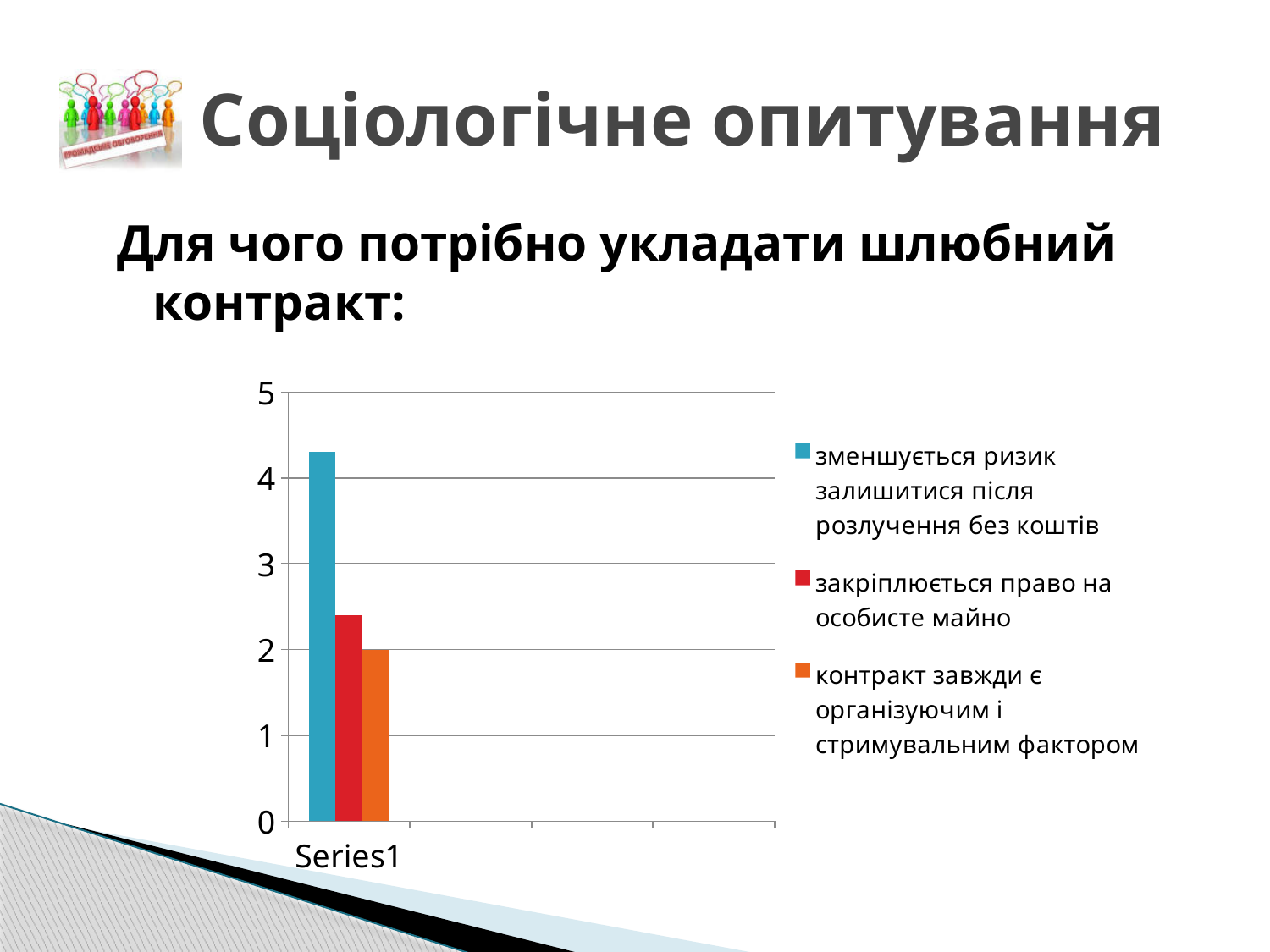
How many series does the legend list? 3 What is the highest value shown on the y axis? 5 Is the value for "закріплюється право на особисте майно" greater or less than 3? less Is the value for "зменшується ризик залишитися після розлучення без коштів" greater or less than 4? greater Which legend entry has the shortest bar? контракт завжди є організуючим і стримувальним фактором What colour is the bar for "контракт завжди є організуючим і стримувальним фактором"? orange What is the category label shown on the x axis? Series1 Which is larger: the bar for "зменшується ризик залишитися після розлучення без коштів" or the bar for "закріплюється право на особисте майно"? зменшується ризик залишитися після розлучення без коштів Is the value for "зменшується ризик залишитися після розлучення без коштів" greater or less than 5? less Which is larger: the bar for "закріплюється право на особисте майно" or the bar for "контракт завжди є організуючим і стримувальним фактором"? закріплюється право на особисте майно What kind of chart is shown on the slide? bar chart Which legend entry has the tallest bar? зменшується ризик залишитися після розлучення без коштів